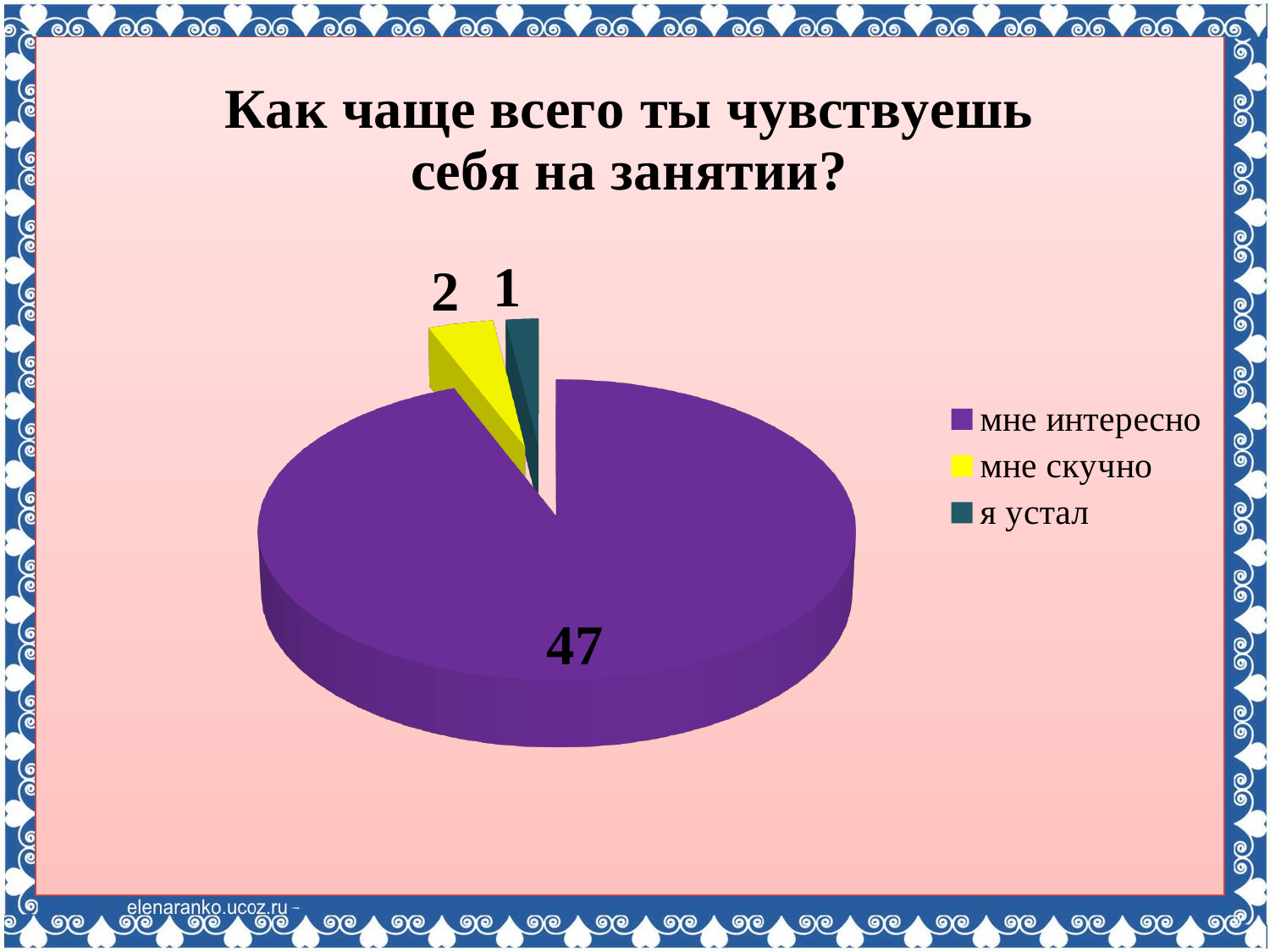
What is the value for "мне интересно"? 47 What share of the pie does "мне интересно" represent? 94% Which category has the smallest slice of the pie? я устал What is the value for "мне скучно"? 2 What colour is the slice for "мне скучно"? yellow Which is larger, the value for "мне скучно" or the value for "я устал"? мне скучно How many categories does the pie chart have? 3 What is the value for "я устал"? 1 What is the total of all the slices in the pie chart? 50 Which category has the largest slice of the pie? мне интересно What kind of chart is shown on the slide? pie chart What is the difference between the values for "мне интересно" and "мне скучно"? 45